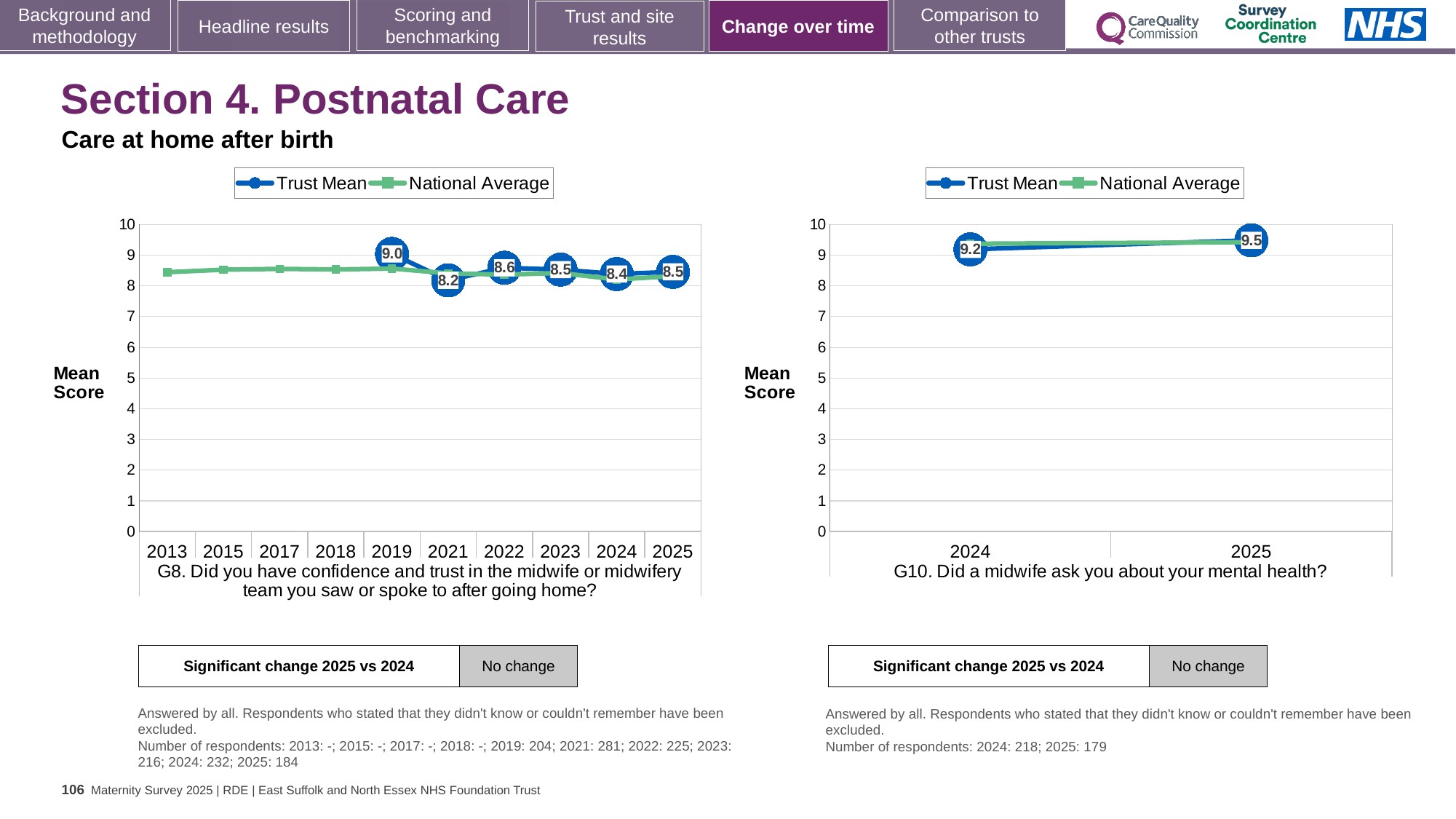
What kind of chart is the G10 chart (right)? line chart On the G8 chart (left), how many series does the legend list? 2 On the G8 chart (left), what is the Trust Mean for 2019? 9.0 On the G8 chart (left), which year has the highest Trust Mean? 2019 On the G10 chart (right), does the Trust Mean rise or fall from 2024 to 2025? rise On the G8 chart (left), what is the difference between the Trust Mean in 2019 and in 2021? 0.8 On the G8 chart (left), what is the Trust Mean for 2021? 8.2 On the G8 chart (left), is the Trust Mean higher in 2022 or in 2024? 2022 On the G10 chart (right), what is the difference between the Trust Mean in 2025 and in 2024? 0.3 On the G8 chart (left), which year has the lowest labelled Trust Mean? 2021 On the G8 chart (left), what is the Trust Mean for 2025? 8.5 On the G10 chart (right), what is the Trust Mean for 2025? 9.5